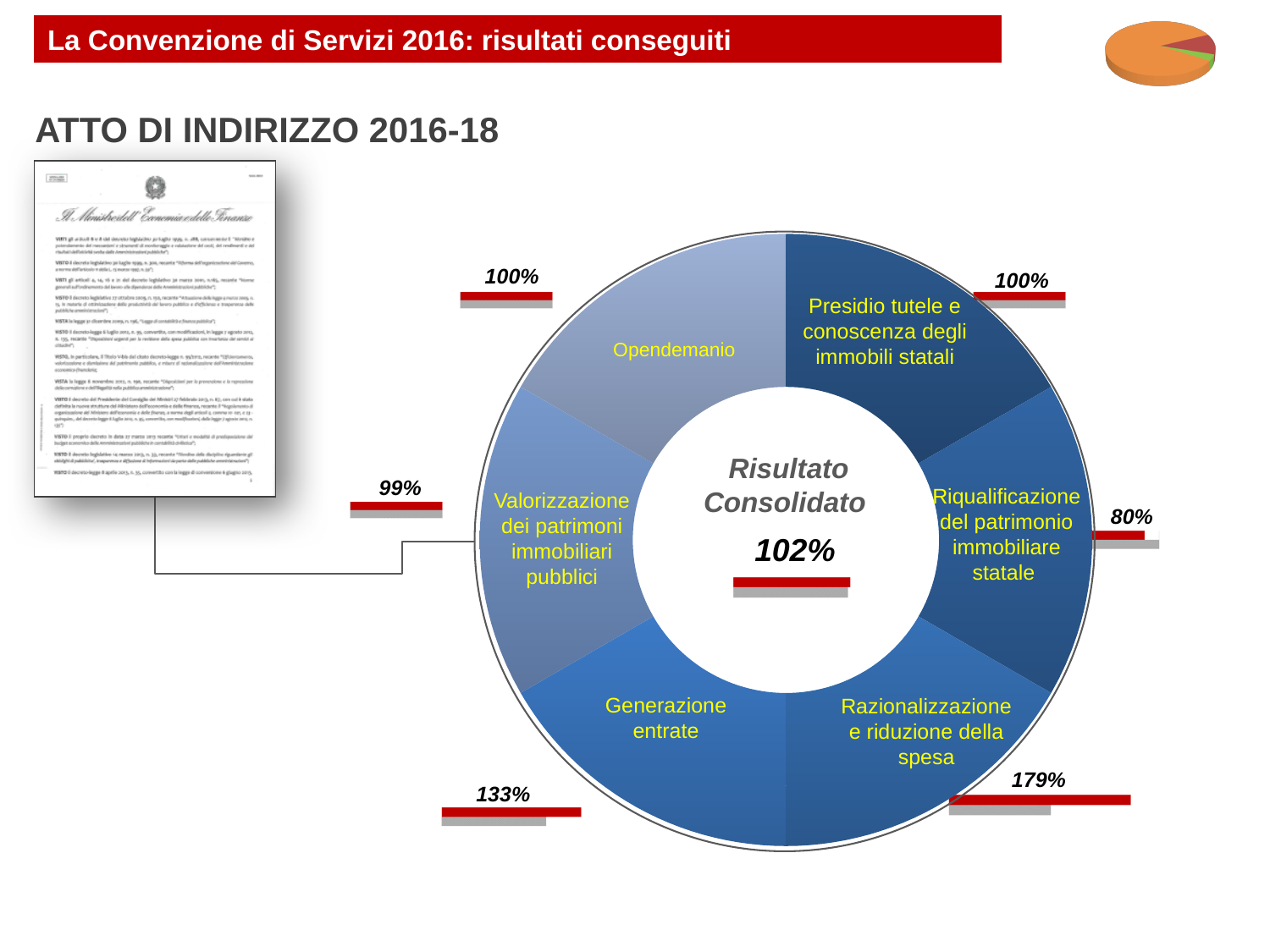
What is the difference between the percentages for Razionalizzazione e riduzione della spesa and Riqualificazione del patrimonio immobiliare statale? 99 percentage points What kind of chart is shown on the slide? Doughnut chart What percentage is shown for Riqualificazione del patrimonio immobiliare statale? 80% What is the Risultato Consolidato value shown in the centre of the chart? 102% What percentage is shown for Opendemanio? 100% Which segment has the highest percentage? Razionalizzazione e riduzione della spesa What percentage is shown for Generazione entrate? 133% What percentage is shown for Razionalizzazione e riduzione della spesa? 179% What percentage is shown for Valorizzazione dei patrimoni immobiliari pubblici? 99% Which has a higher percentage, Generazione entrate or Valorizzazione dei patrimoni immobiliari pubblici? Generazione entrate Which segment has the lowest percentage? Riqualificazione del patrimonio immobiliare statale How many segments does the ring chart have? 6